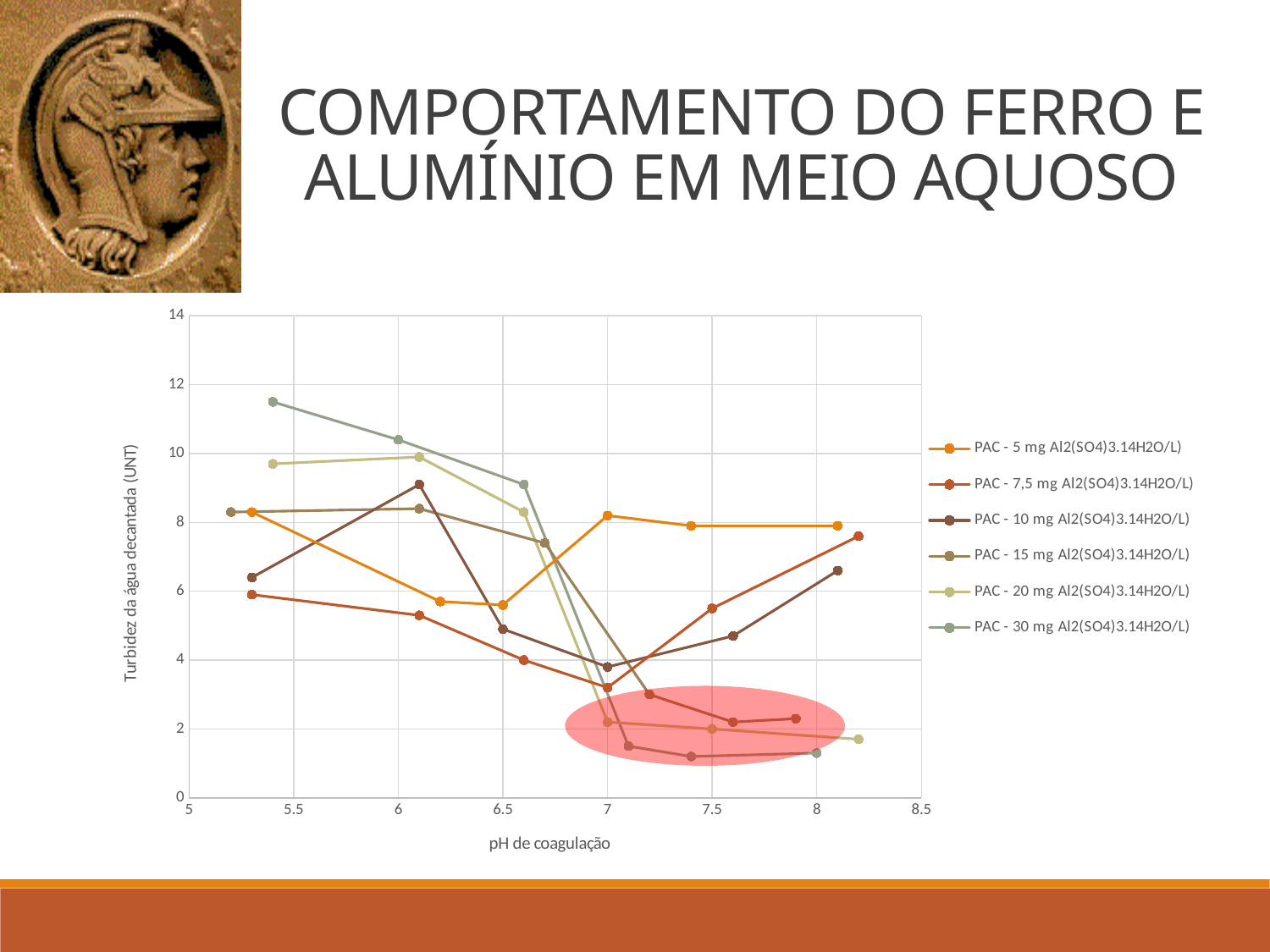
Which series reaches the highest turbidity value on the chart? PAC - 30 mg Al2(SO4)3.14H2O/L Is the value for PAC - 10 mg Al2(SO4)3.14H2O/L at pH 6.1 greater or less than 8? greater How many series does the chart legend list? 6 What is the title of the x axis of the chart? pH de coagulação What is the title of the y axis of the chart? Turbidez da água decantada (UNT) How many data points are plotted for the PAC - 30 mg Al2(SO4)3.14H2O/L series? 6 At pH 7, which series has the larger turbidity value: PAC - 5 mg Al2(SO4)3.14H2O/L or PAC - 7,5 mg Al2(SO4)3.14H2O/L? PAC - 5 mg Al2(SO4)3.14H2O/L What kind of chart is shown on the slide? line chart Do the values for PAC - 30 mg Al2(SO4)3.14H2O/L rise or fall as pH increases along the x axis? fall Is the value for PAC - 30 mg Al2(SO4)3.14H2O/L at pH 5.4 greater or less than 10? greater Is the value for PAC - 5 mg Al2(SO4)3.14H2O/L at pH 7 greater or less than 6? greater